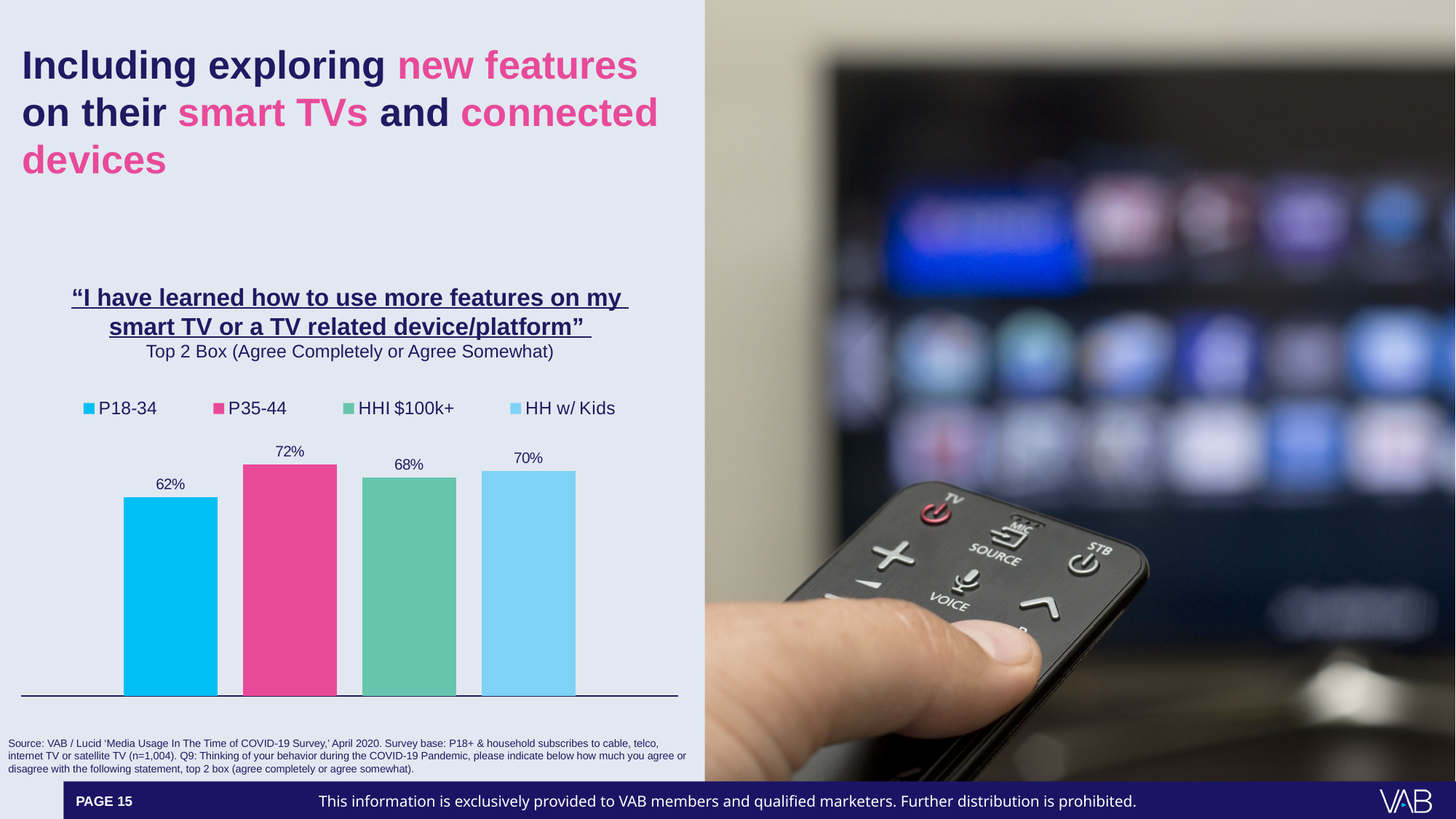
What type of chart is shown on the slide? Bar chart Which is larger, the value for HH w/ Kids or the value for HHI $100k+? HH w/ Kids What percentage of P18-34 agree with the statement "I have learned how to use more features on my smart TV or a TV related device/platform"? 62% Which group has the lowest percentage agreeing with the statement? P18-34 What is the value shown for HH w/ Kids? 70% What colour is the bar for P35-44? Pink What is the difference in percentage points between P35-44 and P18-34? 10 percentage points What is the value shown for HHI $100k+? 68% Which group has the highest percentage agreeing with the statement? P35-44 What is the value shown for P35-44? 72% How many groups are shown in the chart? 4 How many entries does the legend list? 4